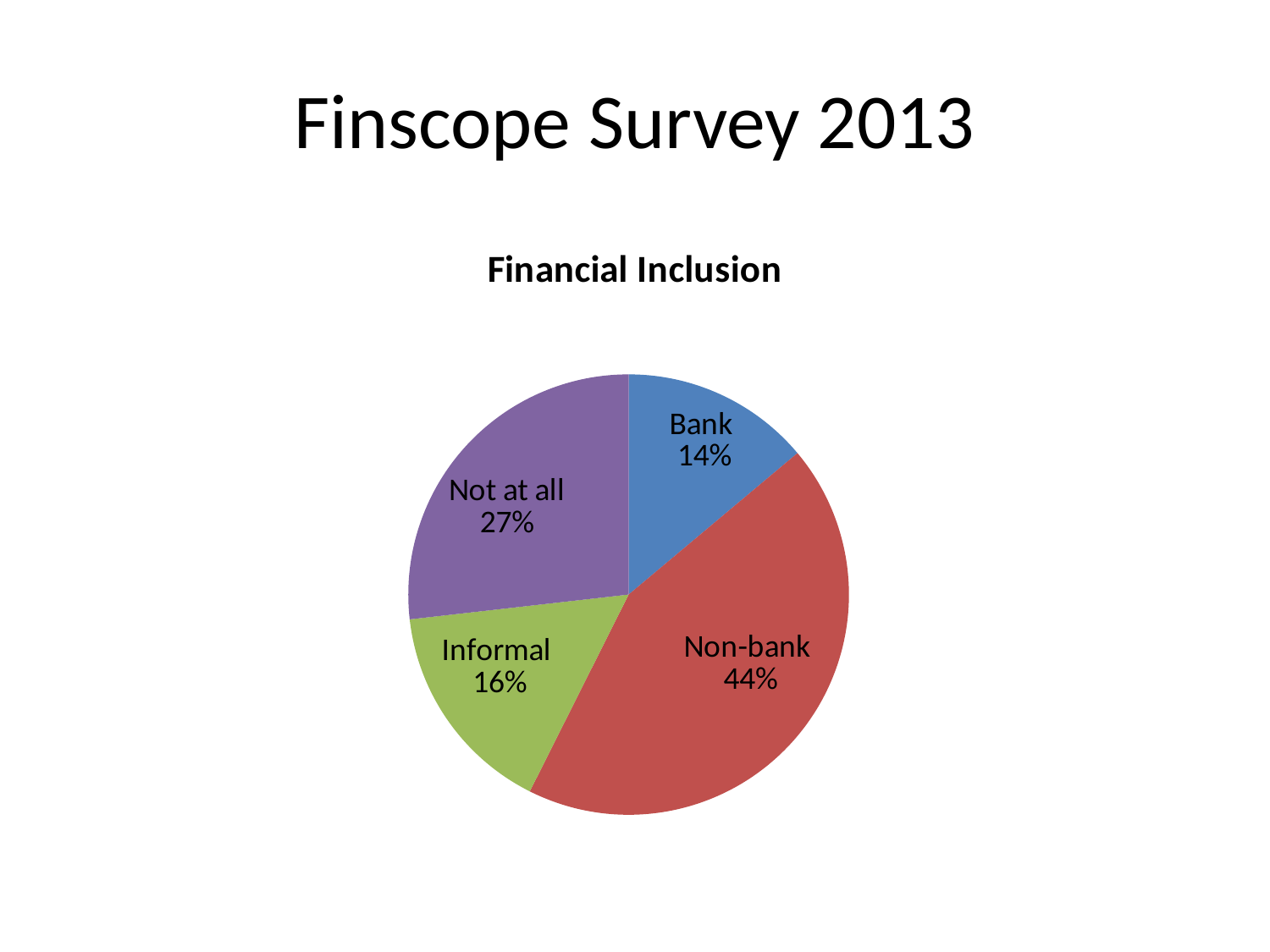
How many slices does the pie chart have? 4 What percentage of the pie is the Informal slice? 16% What percentage of the pie is the Non-bank slice? 44% What percentage of the pie is the Not at all slice? 27% What is the title of the chart? Financial Inclusion What colour is the Non-bank slice? red Which is larger, the Informal slice or the Bank slice? Informal Which category has the largest share of the pie? Non-bank What kind of chart is shown on the slide? pie chart What percentage of the pie is the Bank slice? 14% Which category has the smallest share of the pie? Bank What is the difference in percentage points between the Non-bank and Not at all slices? 17